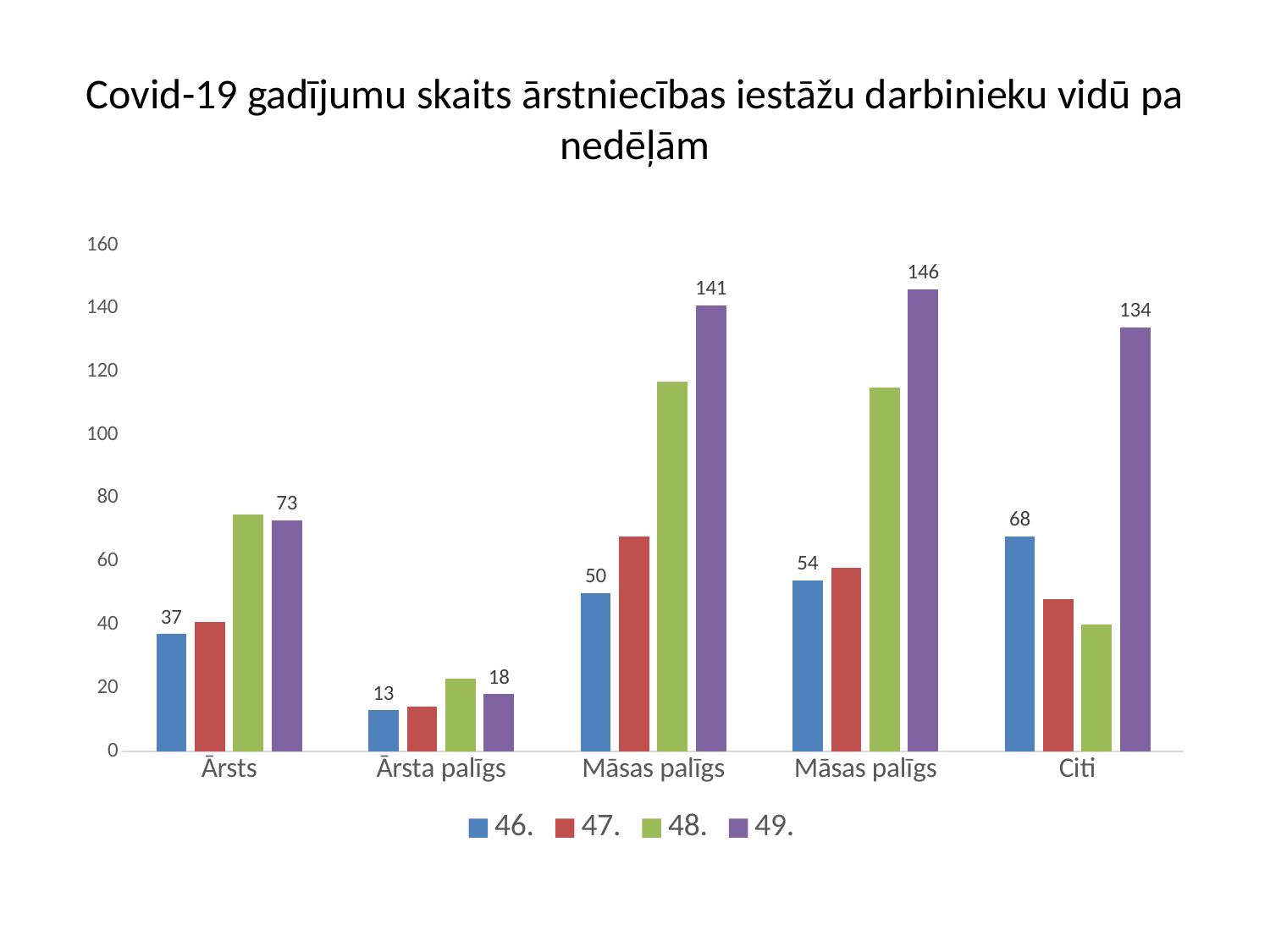
What is the value for Citi in series 49.? 134 How many categories are shown on the x axis? 5 In series 46., which is larger: Ārsts or Citi? Citi What is the value for Ārsts in series 46.? 37 What is the value for Ārsta palīgs in series 49.? 18 Which category has the highest value in series 49.? Māsas palīgs What is the difference between the series 49. and series 46. values for Ārsts? 36 Which category has the lowest value in series 46.? Ārsta palīgs Is the value for Ārsts in series 48. greater or less than 60? greater Is the value for Ārsta palīgs in series 47. greater or less than 20? less How many series does the legend list? 4 What is the difference between the series 49. and series 46. values for Citi? 66